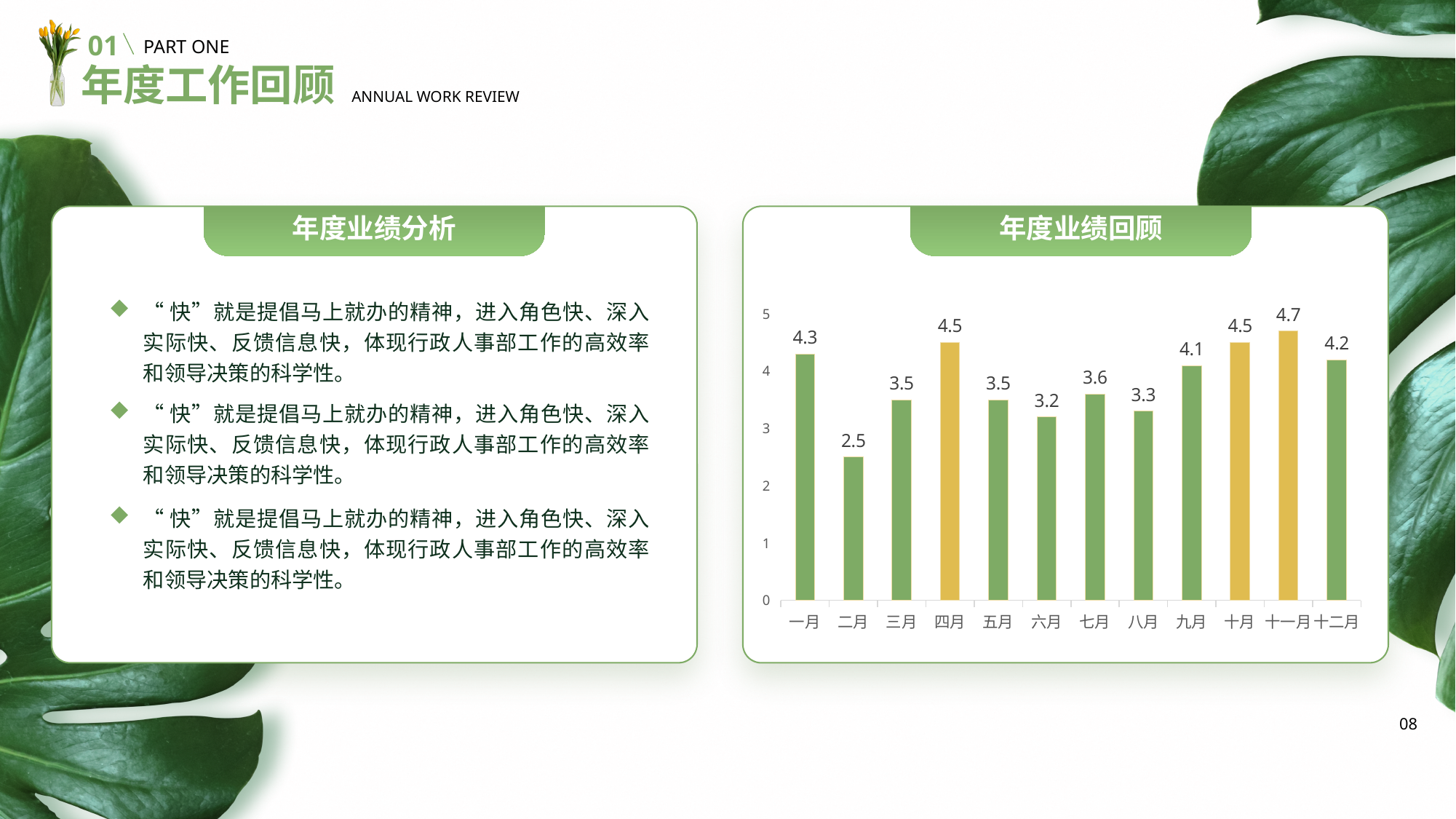
Which months are shown with yellow bars in the 年度业绩回顾 chart? 四月, 十月, 十一月 What is the value for 七月 in the 年度业绩回顾 chart? 3.6 What is the difference between the values for 十一月 and 二月 in the 年度业绩回顾 chart? 2.2 How many months are shown on the x axis of the 年度业绩回顾 chart? 12 What kind of chart is the 年度业绩回顾 chart? bar chart Which month has the highest value in the 年度业绩回顾 chart? 十一月 Which month has the lowest value in the 年度业绩回顾 chart? 二月 What is the value for 二月 in the 年度业绩回顾 chart? 2.5 What is the value for 十二月 in the 年度业绩回顾 chart? 4.2 Is the value for 六月 in the 年度业绩回顾 chart greater or less than 3? greater Which is larger in the 年度业绩回顾 chart, the value for 九月 or the value for 八月? 九月 What is the difference between the values for 一月 and 六月 in the 年度业绩回顾 chart? 1.1